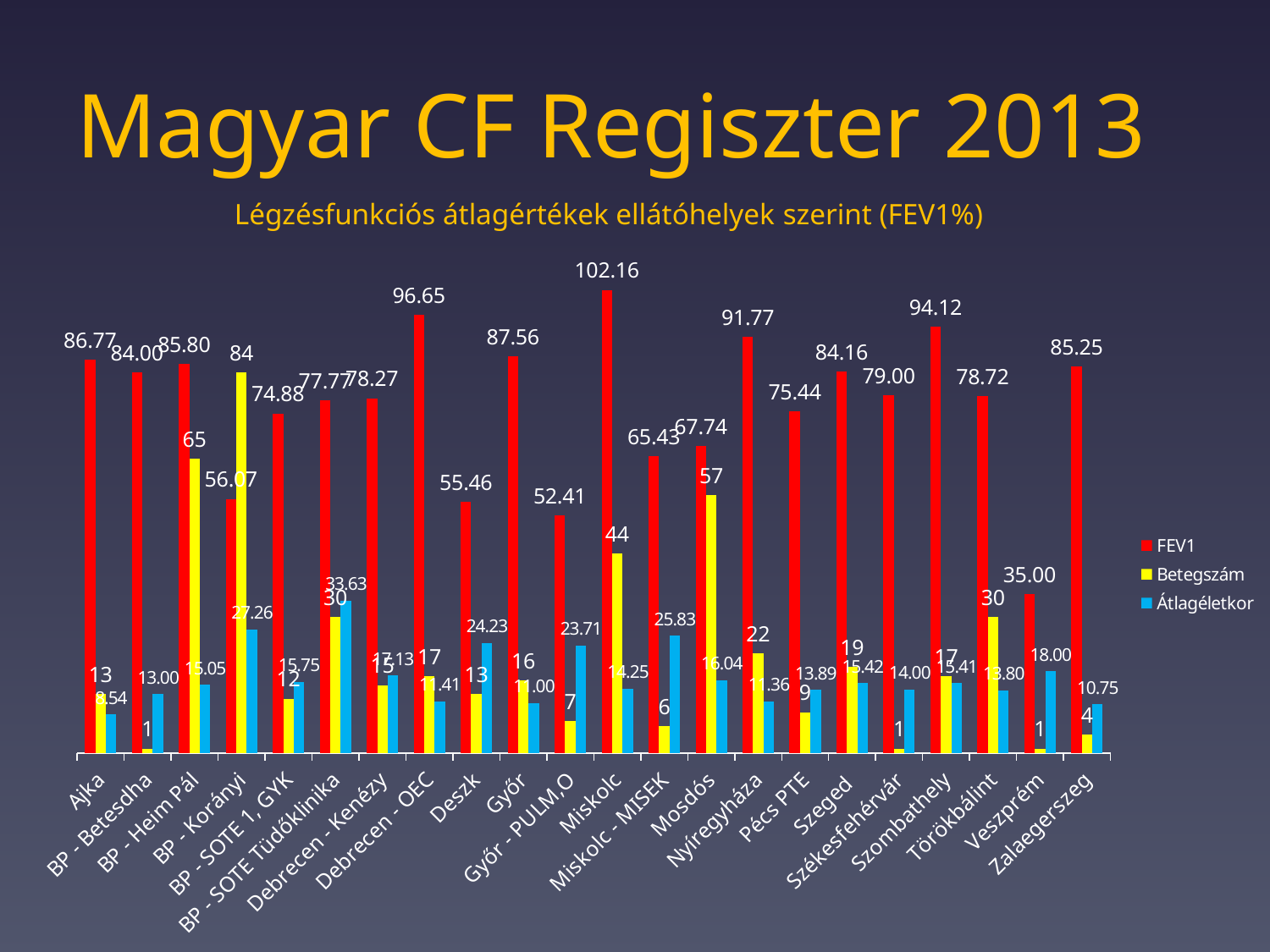
What type of chart is shown on the slide? Bar chart What is the difference between the FEV1 values for Szombathely and Szeged? 9.96 Which category has the lowest FEV1 value? Veszprém How many categories are shown on the x axis? 22 How many series does the legend list? 3 What is the Betegszám value for Mosdós? 57 What is the FEV1 value for Miskolc? 102.16 Which is larger, the FEV1 value for Nyíregyháza or for Győr? Nyíregyháza Which category has the highest Betegszám value? BP - Korányi Which category has the highest FEV1 value? Miskolc What is the FEV1 value for Veszprém? 35.00 What is the Átlagéletkor value for Deszk? 24.23